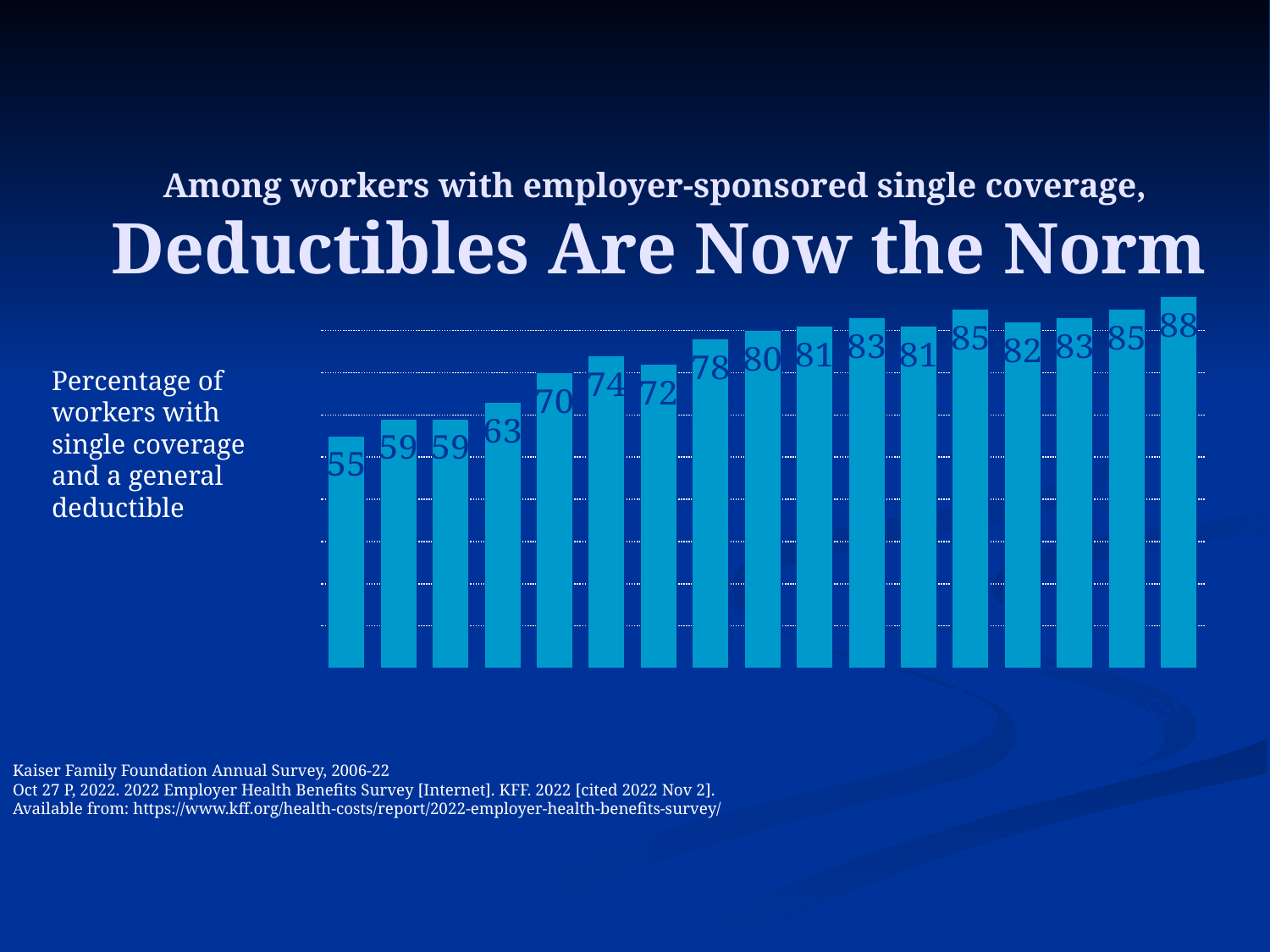
Which is larger, the value of the sixth bar from the left or the seventh bar from the left? the sixth bar (74) What does the text to the left of the chart say the bars represent? Percentage of workers with single coverage and a general deductible What is the highest value labelled on any bar in the chart? 88 What is the difference between the value of the last bar and the value of the first bar? 33 What is the value shown on the first (leftmost) bar? 55 Do the bar values generally rise or fall from left to right across the chart? rise How many bars are plotted in the chart? 17 What is the value shown on the last (rightmost) bar? 88 What is the lowest value labelled on any bar in the chart? 55 What kind of chart is shown on the slide? bar chart What is the value shown on the fifth bar from the left? 70 What is the difference between the fourth bar (63) and the fifth bar (70)? 7